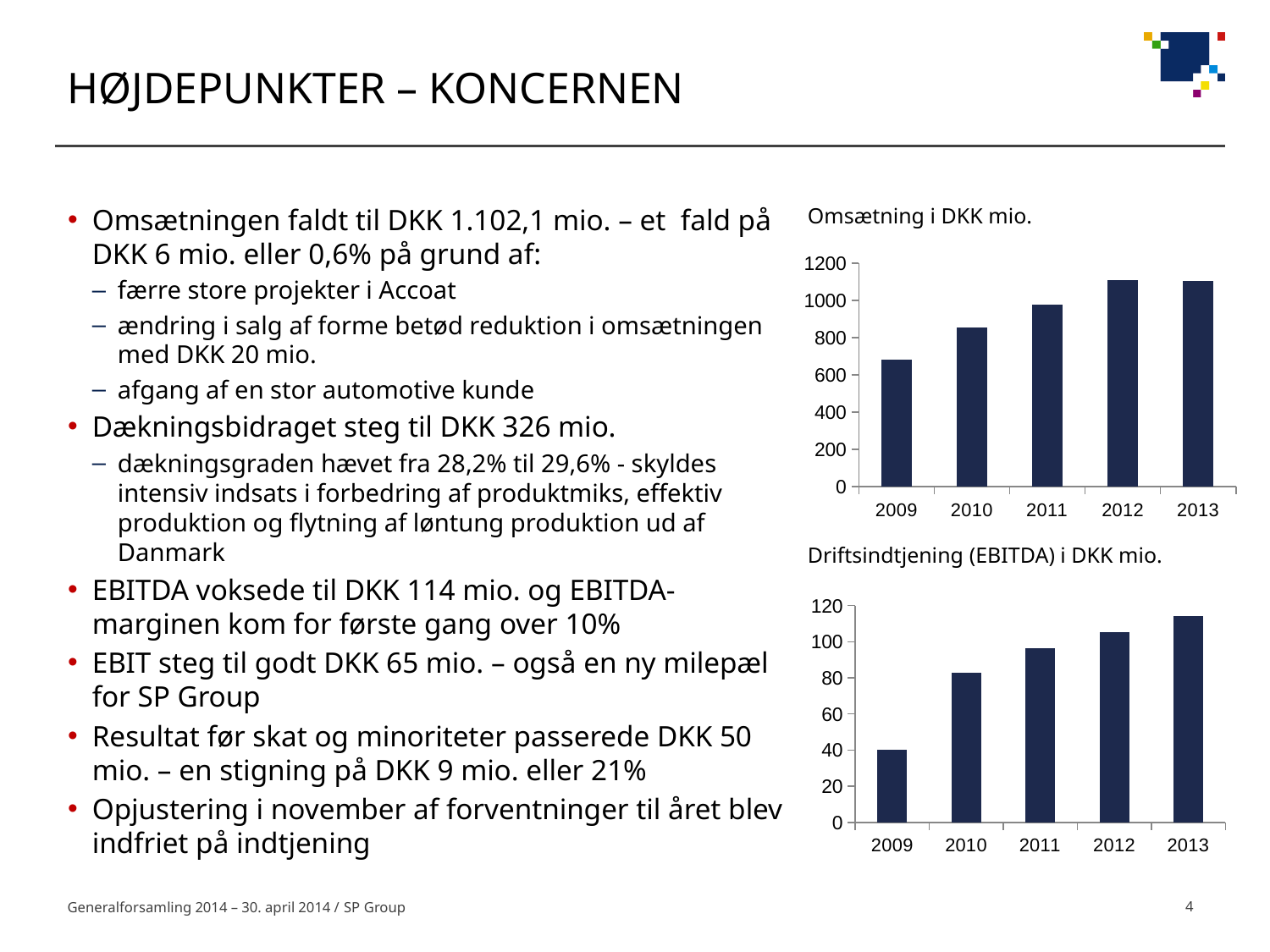
In the 'Omsætning i DKK mio.' chart, which year has the lowest value? 2009 What kind of chart is the 'Omsætning i DKK mio.' chart? bar chart How many years are shown on the 'Omsætning i DKK mio.' chart? 5 In the 'Driftsindtjening (EBITDA) i DKK mio.' chart, which year has the highest value? 2013 In the 'Omsætning i DKK mio.' chart, which is larger, the value for 2010 or the value for 2011? 2011 What kind of chart is the 'Driftsindtjening (EBITDA) i DKK mio.' chart? bar chart In the 'Driftsindtjening (EBITDA) i DKK mio.' chart, which year has the lowest value? 2009 In the 'Driftsindtjening (EBITDA) i DKK mio.' chart, is the value for 2012 greater or less than 100? greater In the 'Driftsindtjening (EBITDA) i DKK mio.' chart, do the values rise or fall from 2009 to 2013? rise In the 'Omsætning i DKK mio.' chart, is the value for 2009 greater or less than 600? greater